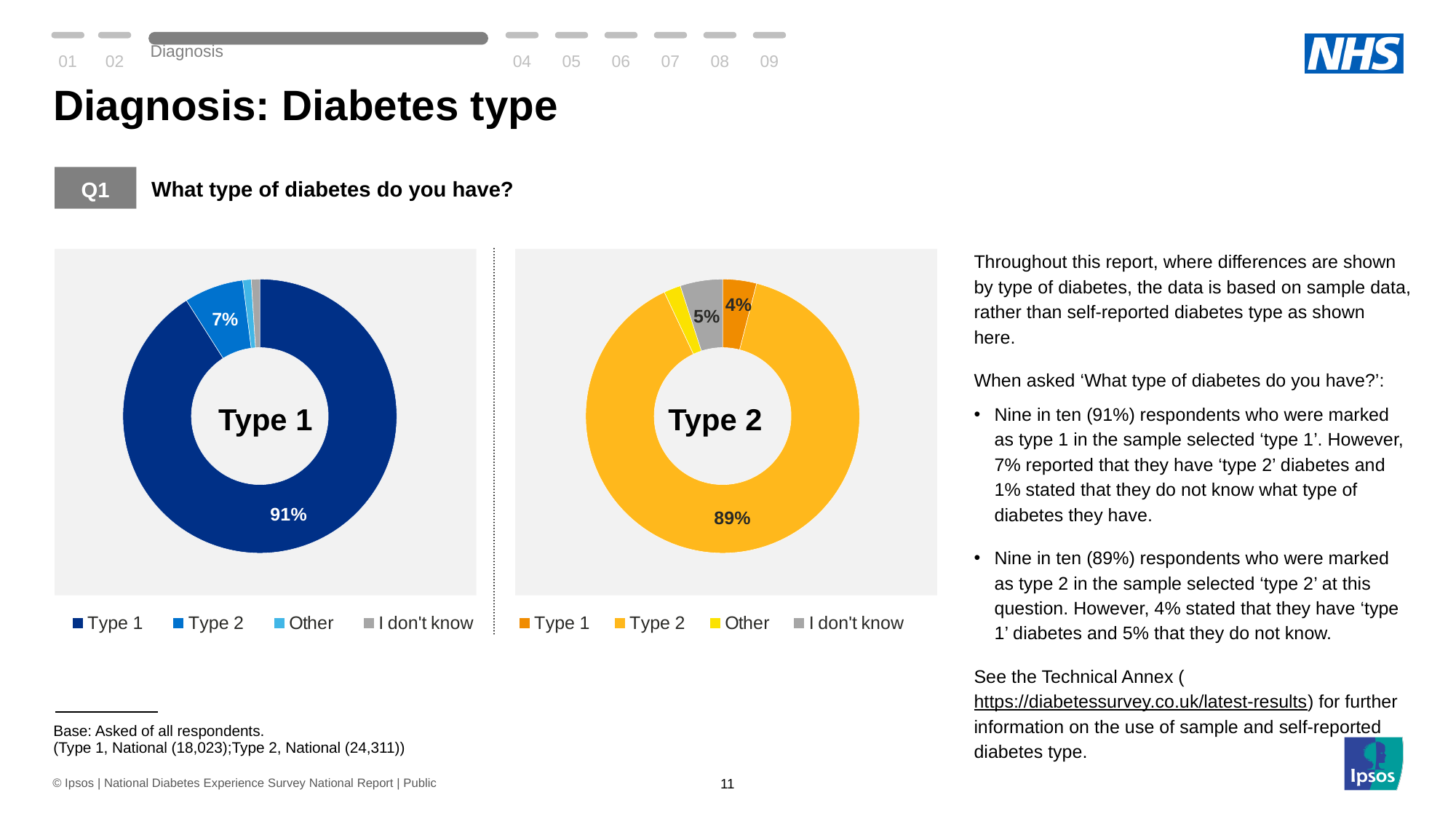
In the Type 2 chart on the right, what share of respondents selected 'Type 1'? 4% In the Type 1 chart on the left, what is the difference between the 'Type 1' share and the 'Type 2' share? 84 percentage points In the Type 1 chart on the left, which category has the largest share? Type 1 In the Type 2 chart on the right, what share of respondents selected 'I don't know'? 5% What kind of chart is used on this slide? Doughnut (pie) chart In the Type 2 chart on the right, which category has the largest share? Type 2 What colour is the 'Type 2' segment in the Type 2 chart on the right? Orange/yellow How many categories does the legend of the Type 1 chart on the left list? 4 In the Type 1 chart on the left, what share of respondents selected 'Type 2'? 7% In the Type 2 chart on the right, what share of respondents selected 'Type 2'? 89% In the Type 2 chart on the right, which is larger: the 'I don't know' share or the 'Type 1' share? I don't know In the Type 1 chart on the left, what share of respondents selected 'Type 1'? 91%